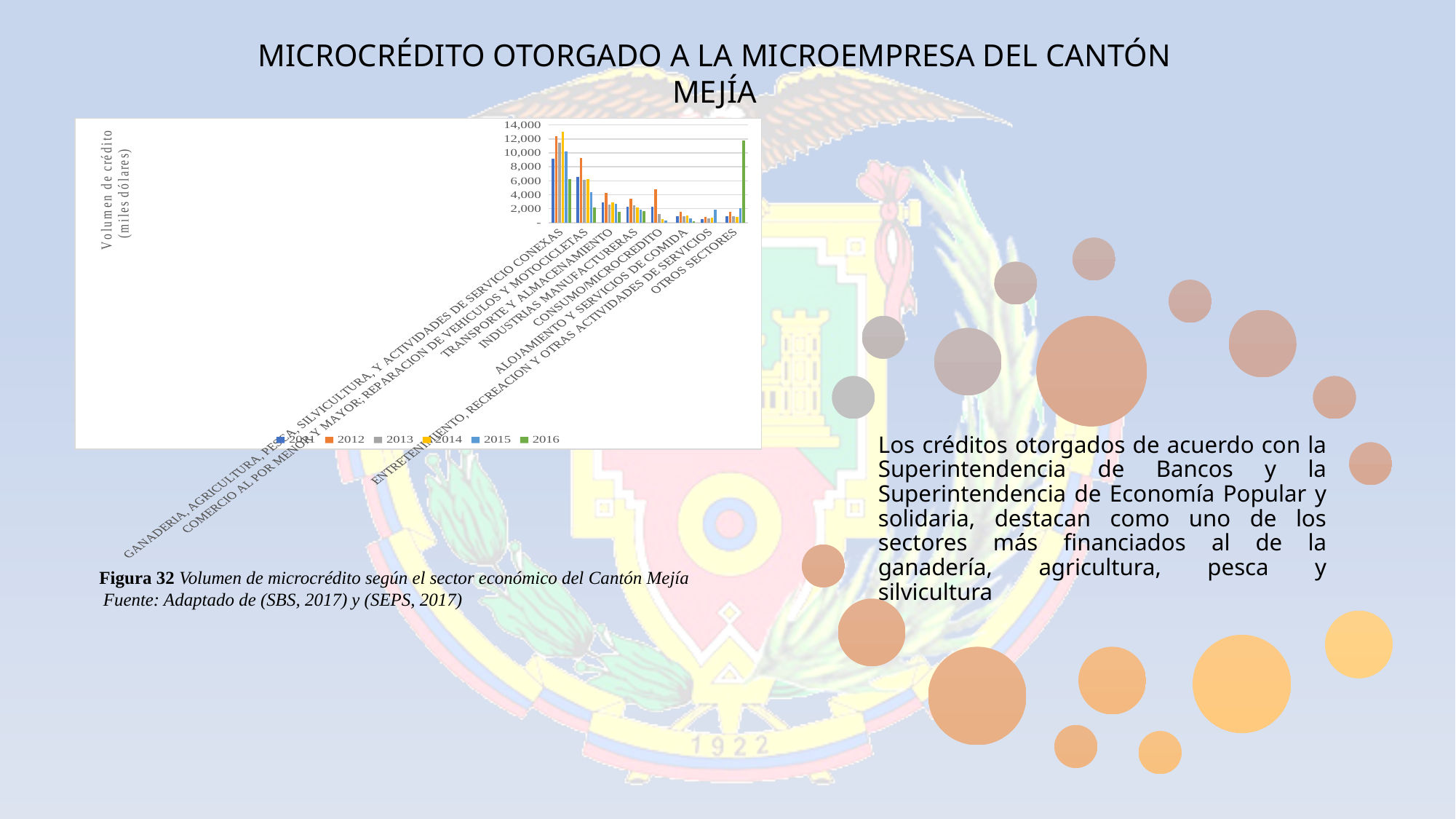
Is the 2012 value for ALOJAMIENTO Y SERVICIOS DE COMIDA greater or less than 2,000? less What is the title of the vertical axis? Volumen de crédito (miles dólares) Is the 2016 value for OTROS SECTORES greater or less than 10,000? greater Which sector has the highest 2012 value? GANADERIA, AGRICULTURA, PESCA, SILVICULTURA, Y ACTIVIDADES DE SERVICIO CONEXAS How many economic sector categories are shown on the x axis? 8 What kind of chart is shown on the slide? bar chart Is the 2016 value for COMERCIO AL POR MENOR Y MAYOR; REPARACION DE VEHICULOS Y MOTOCICLETAS greater or less than 4,000? less For OTROS SECTORES, which year has the larger value, 2016 or 2012? 2016 Which years are listed in the legend? 2011, 2012, 2013, 2014, 2015, 2016 For GANADERIA, AGRICULTURA, PESCA, SILVICULTURA, Y ACTIVIDADES DE SERVICIO CONEXAS, which year has the larger value, 2014 or 2016? 2014 How many series does the legend list? 6